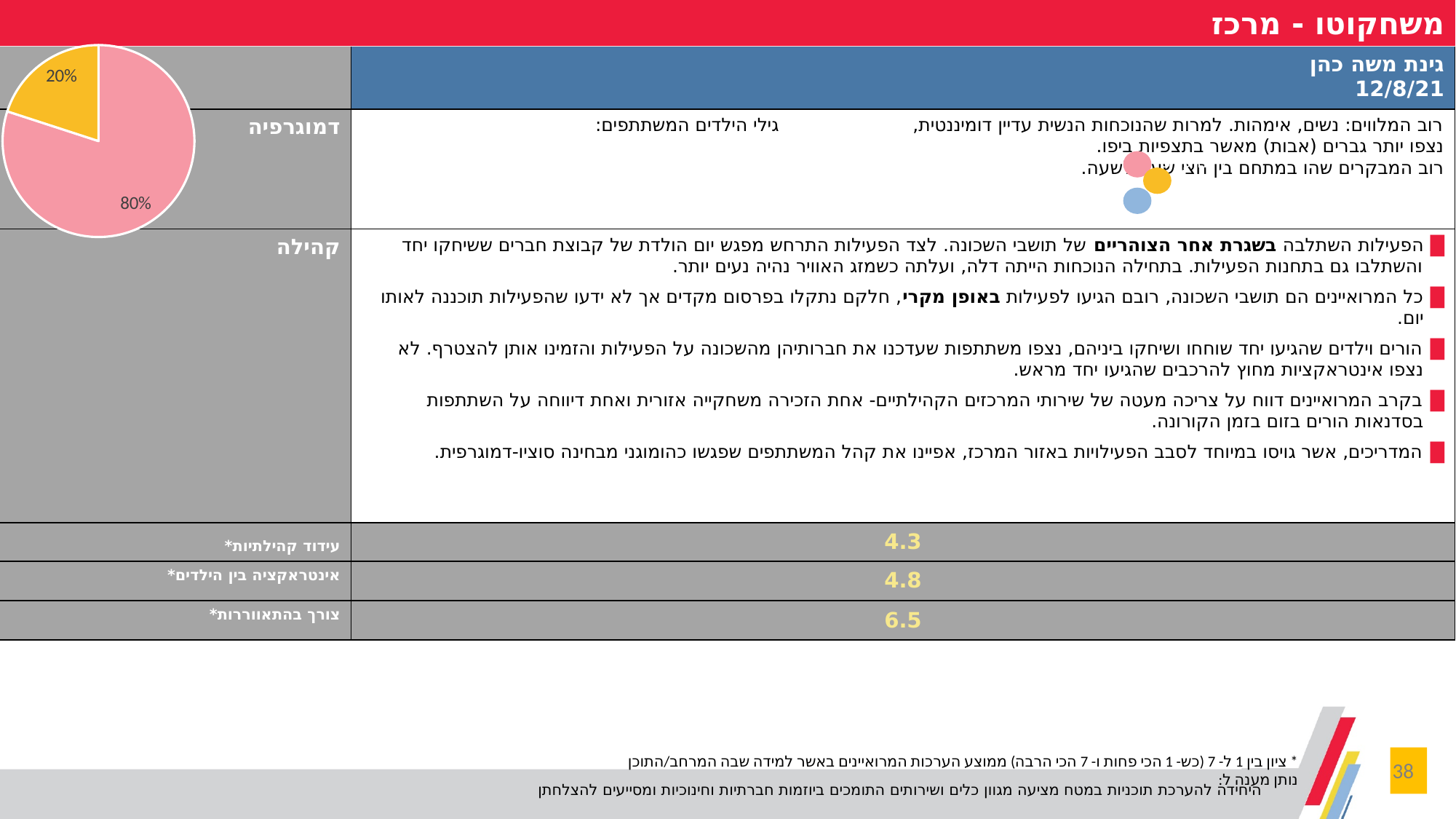
What colour is the largest slice of the pie chart? pink How many slices does the pie chart in the top-left corner have? 2 What is the value labelled on the pink slice of the pie chart? 80% Do the two slices of the pie chart add up to 100%? yes What is the difference in percentage points between the two slices of the pie chart? 60 What is the value labelled on the yellow slice of the pie chart? 20% What share of the pie chart does the yellow slice represent? 20% Which slice of the pie chart is larger, the pink one or the yellow one? the pink one What percentage is shown on the largest slice of the pie chart? 80% What kind of chart is shown in the top-left corner of the slide? pie chart What percentage is shown on the smallest slice of the pie chart? 20%